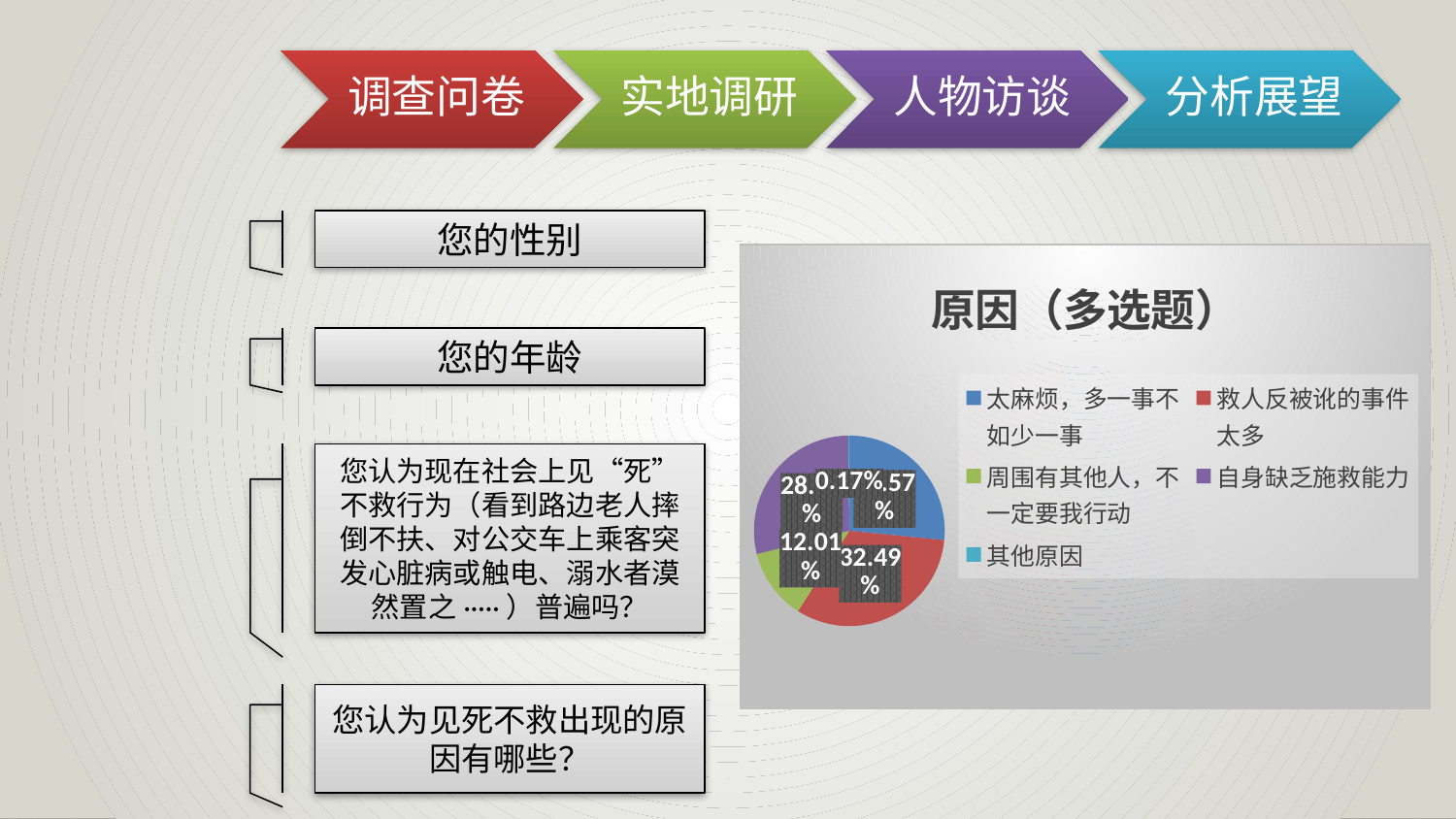
How many categories does the pie chart have? 5 How many entries does the legend list? 5 What percentage is shown for 周围有其他人，不一定要我行动? 12.01% Which reason has the smallest share of the pie? 其他原因 What percentage is shown for 救人反被讹的事件太多? 32.49% What kind of chart is shown on the slide? pie chart Which reason has the largest share of the pie? 救人反被讹的事件太多 Which is larger: the share for 救人反被讹的事件太多 or the share for 周围有其他人，不一定要我行动? 救人反被讹的事件太多 What is the title of the chart? 原因（多选题） What is the difference between the share for 救人反被讹的事件太多 and the share for 周围有其他人，不一定要我行动? 20.48% Which colour represents 自身缺乏施救能力 in the pie chart? purple